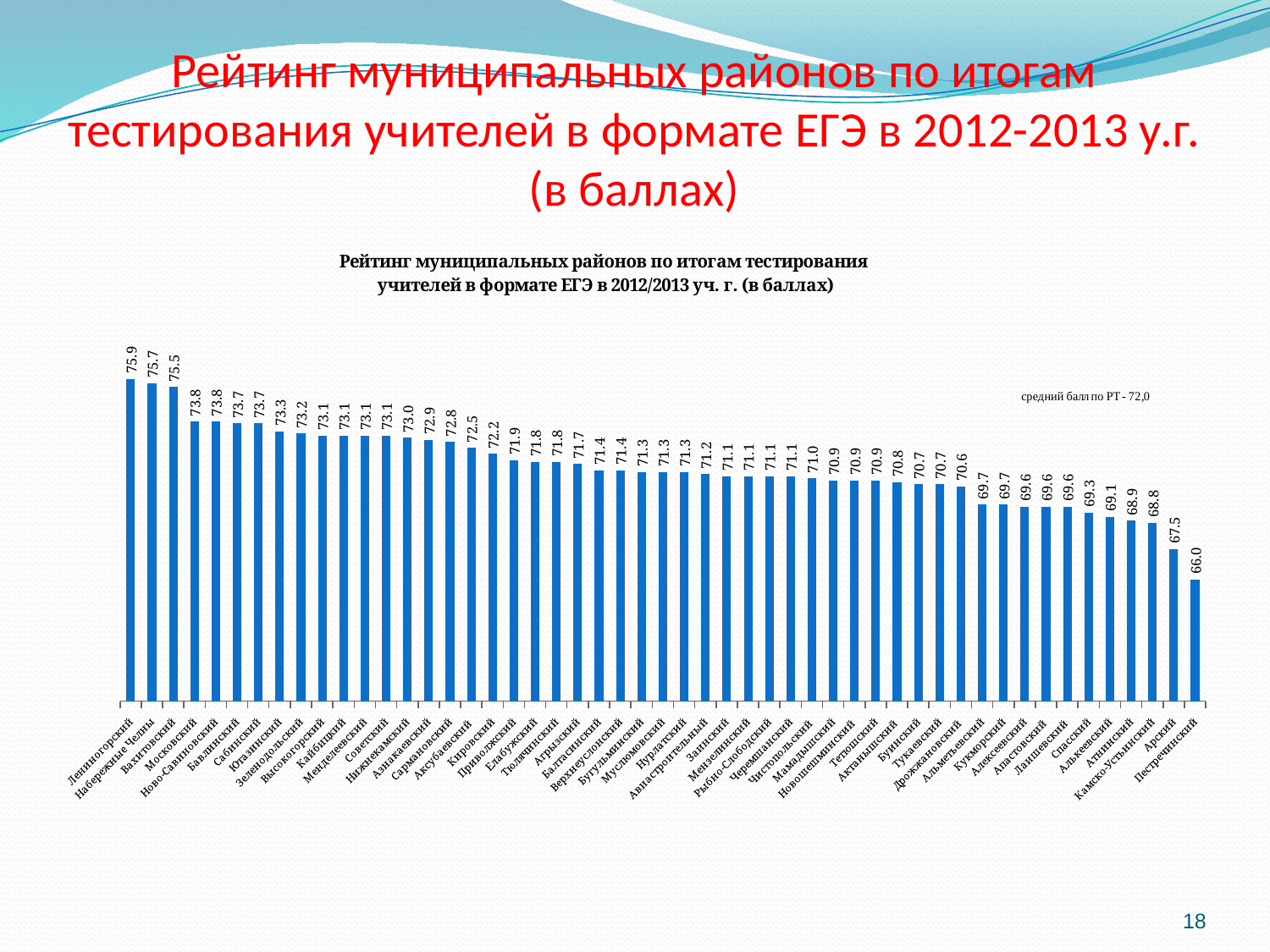
What average score for РТ is noted on the chart? 72,0 Which district has the highest score in the chart? Лениногорский What is the score for Набережные Челны? 75.7 How many districts are plotted in the chart? 51 Do the scores rise or fall from left to right along the x axis? Fall What is the score for Пестречинский? 66.0 What is the score for Арский? 67.5 What is the difference between the scores of Лениногорский and Пестречинский? 9.9 What kind of chart is shown on the slide? Bar chart Which district has the lowest score in the chart? Пестречинский Which has a higher score, Вахитовский or Арский? Вахитовский What is the score for Лениногорский? 75.9